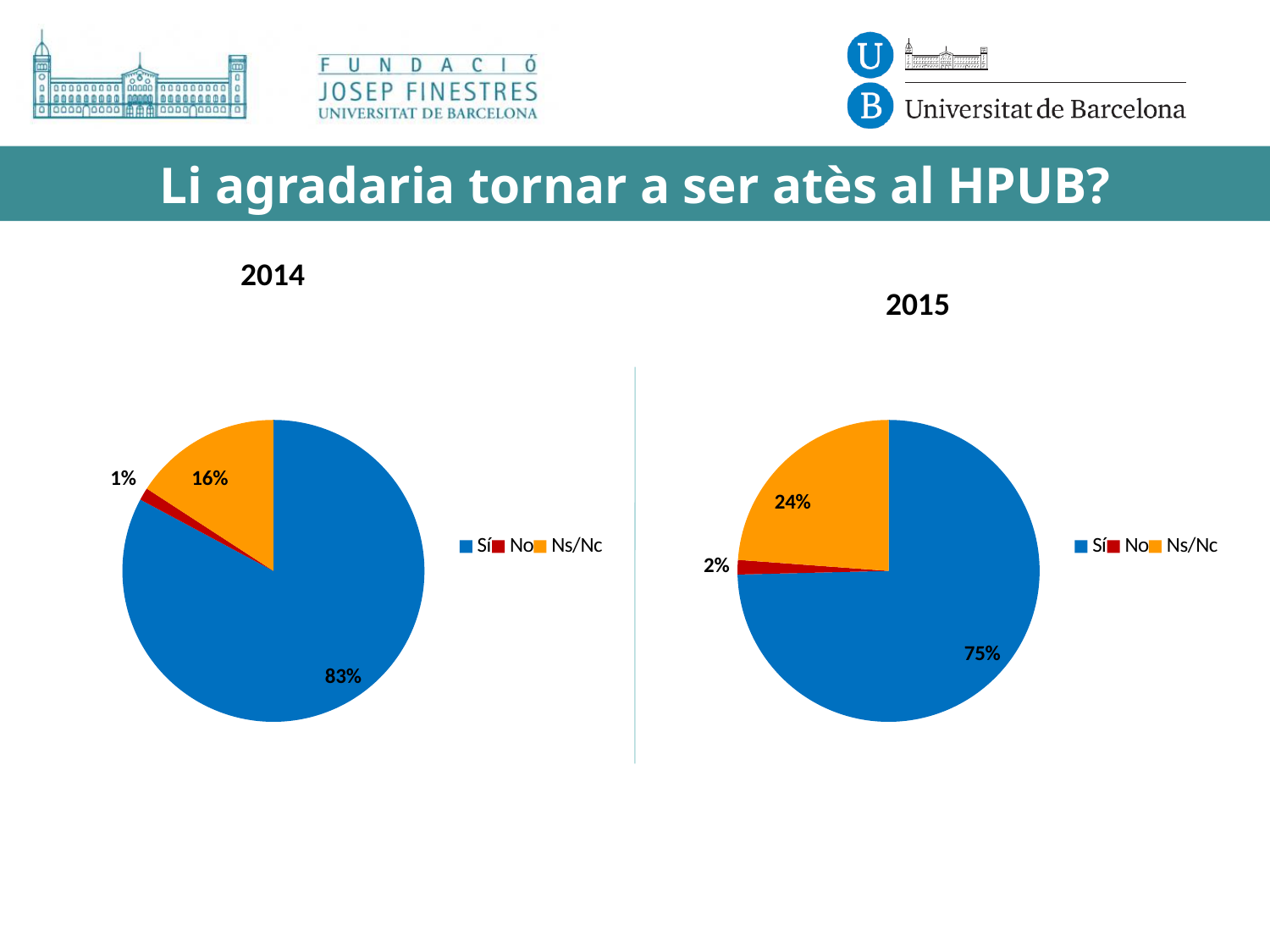
Which chart shows a larger share for Ns/Nc, the 2014 chart or the 2015 chart? 2015 What is the difference between the Sí share in the 2014 chart and the Sí share in the 2015 chart? 8% What type of chart is used for the 2014 data? Pie chart In the 2015 pie chart, what percentage is shown for Ns/Nc? 24% In the 2015 pie chart, which category has the smallest share? No How many slices does the 2014 pie chart have? 3 In the 2014 pie chart, what is the difference between the Ns/Nc share and the No share? 15% How many entries does the legend of the 2015 chart list? 3 In the 2015 pie chart, what percentage is shown for No? 2% In the 2014 pie chart, what percentage is shown for Sí? 83% What colour represents Ns/Nc in the 2015 pie chart? Orange In the 2014 pie chart, which category has the largest share? Sí